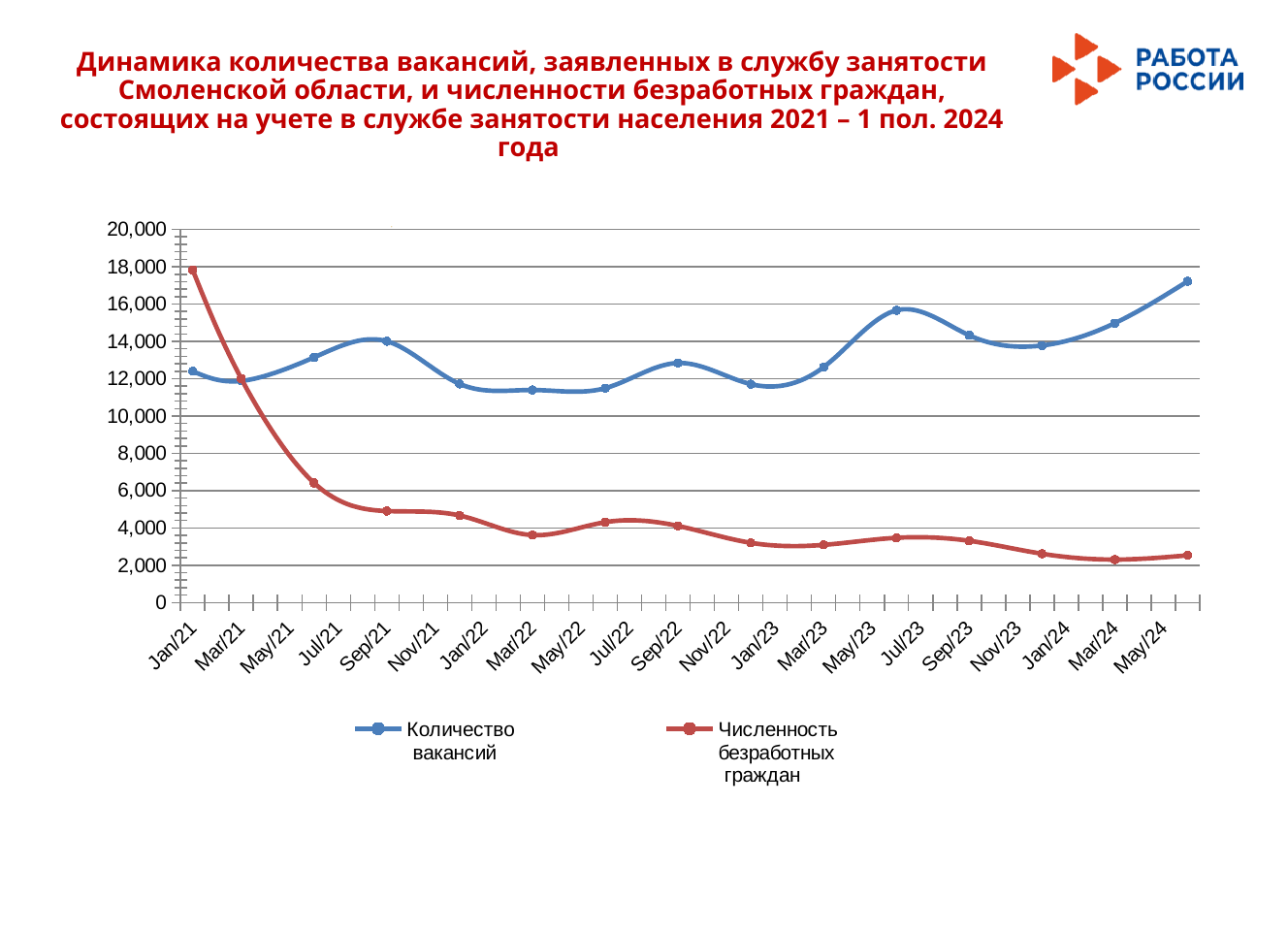
Which series is drawn in red? Численность безработных граждан What kind of chart is shown on the slide? Line chart Is the value for Количество вакансий in May/24 greater or less than 16,000? greater Is the value for Численность безработных граждан in Sep/21 greater or less than 6,000? less Does Численность безработных граждан generally rise or fall from Jan/21 to May/24? Fall Is the value for Количество вакансий in Jul/23 greater or less than 14,000? greater How many series does the legend list? 2 Which series is drawn in blue? Количество вакансий At which point on the x axis is Численность безработных граждан highest? Jan/21 In Jan/21, which is larger: Количество вакансий or Численность безработных граждан? Численность безработных граждан